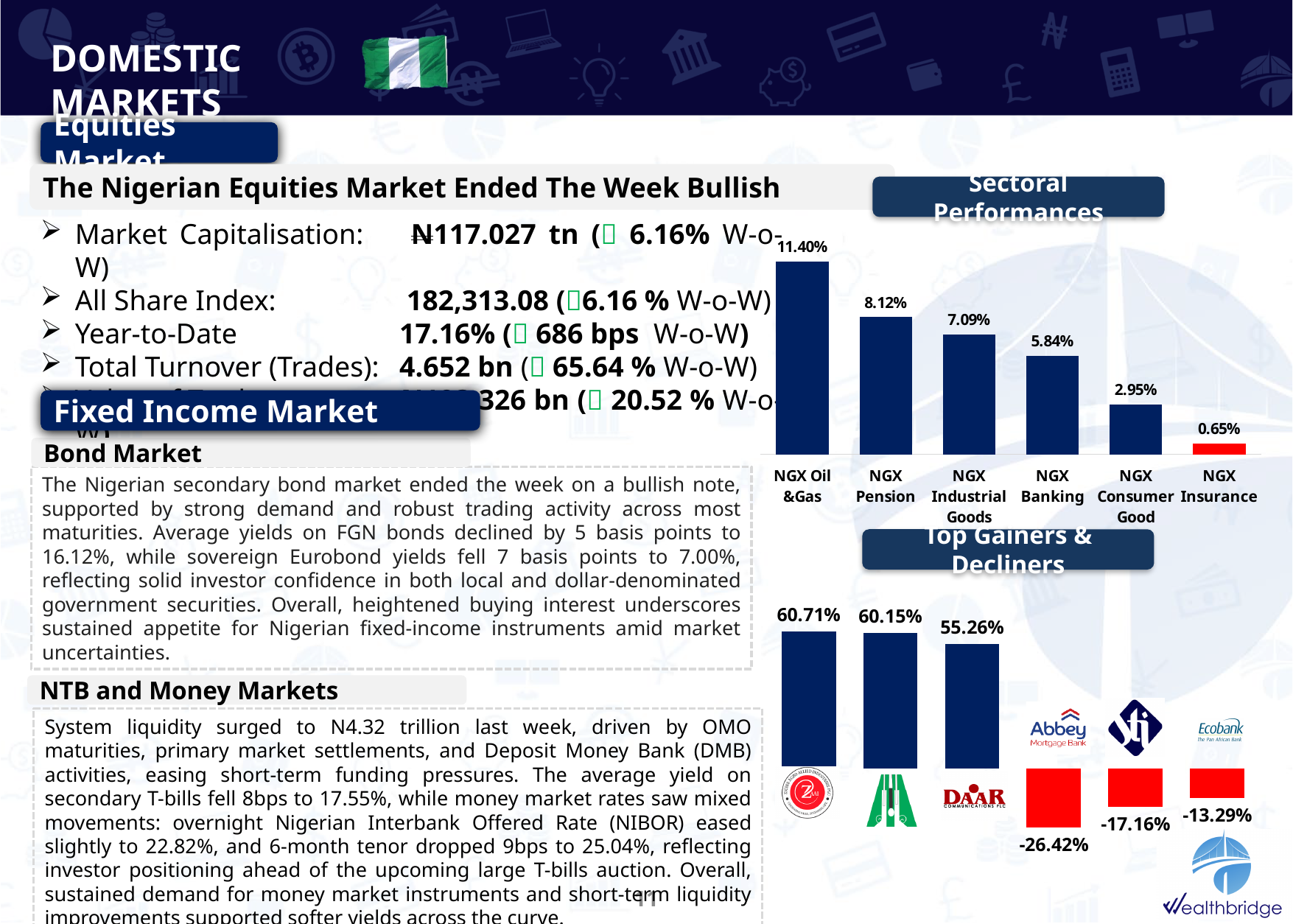
How many sectors are shown in the Sectoral Performances chart? 6 In the Sectoral Performances chart, do the values rise or fall from left to right? Fall In the Sectoral Performances chart, which is larger, the value for NGX Consumer Good or NGX Banking? NGX Banking In the Top Gainers & Decliners chart, what is the value of the largest decliner? -26.42% What type of chart is the Sectoral Performances chart? Bar chart In the Top Gainers & Decliners chart, what is the value of the largest gainer (leftmost bar)? 60.71% In the Sectoral Performances chart, what is the difference between the values for NGX Pension and NGX Industrial Goods? 1.03% In the Sectoral Performances chart, which sector has the lowest value? NGX Insurance In the Sectoral Performances chart, what is the value for NGX Insurance? 0.65% In the Sectoral Performances chart, what is the value for NGX Banking? 5.84% In the Sectoral Performances chart, which sector has the highest value? NGX Oil & Gas In the Sectoral Performances chart, what is the value for NGX Oil & Gas? 11.40%